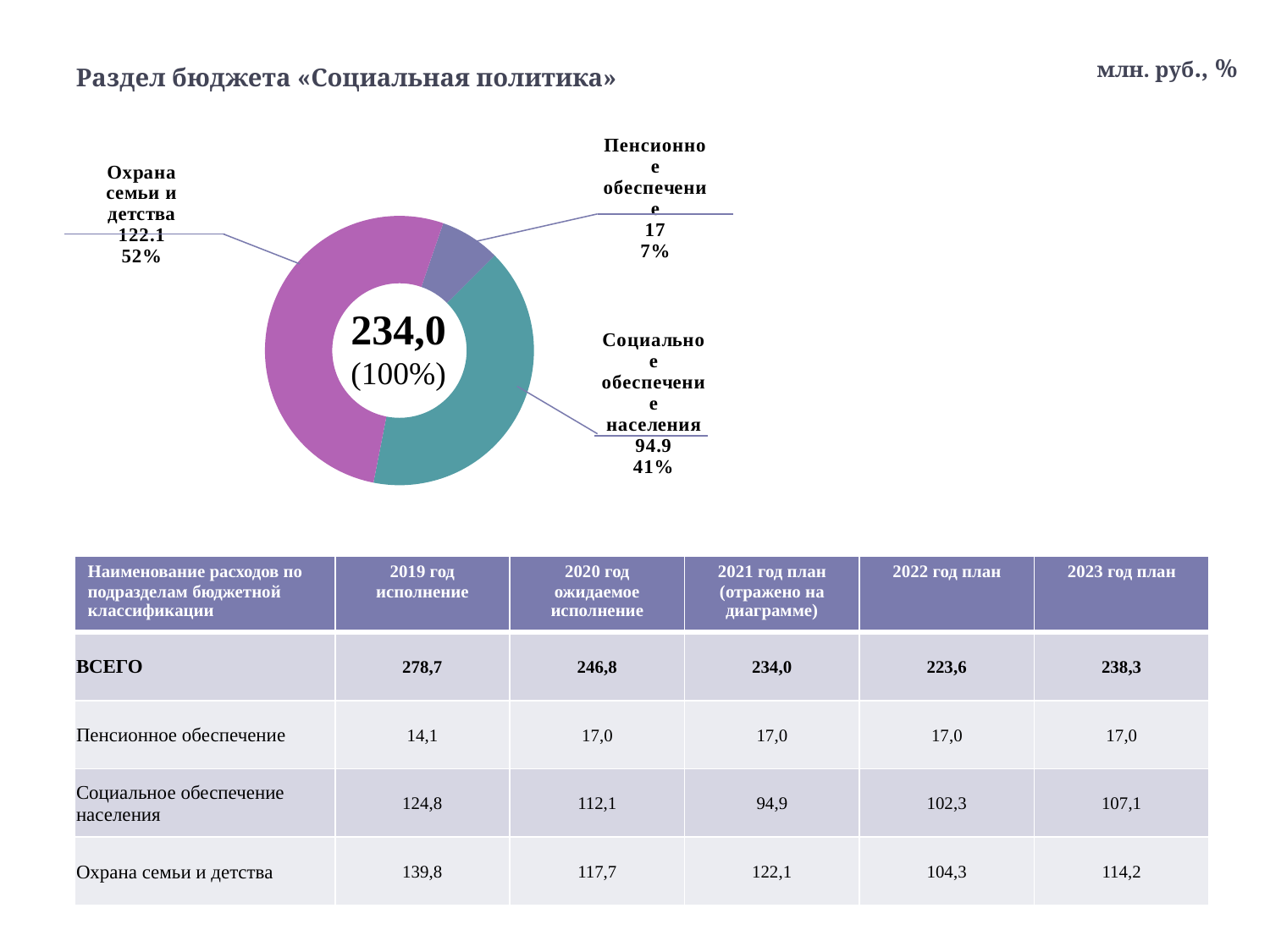
What share of the donut chart does Пенсионное обеспечение represent? 7% Which is larger on the donut chart: Социальное обеспечение населения or Пенсионное обеспечение? Социальное обеспечение населения What share of the donut chart does Охрана семьи и детства represent? 52% What value is shown for Социальное обеспечение населения on the donut chart? 94.9 Which category has the smallest slice in the donut chart? Пенсионное обеспечение What value is shown for Охрана семьи и детства on the donut chart? 122.1 What value is shown for Пенсионное обеспечение on the donut chart? 17 What is the difference between the shares of Охрана семьи и детства and Социальное обеспечение населения on the donut chart? 11% Which category has the largest slice in the donut chart? Охрана семьи и детства How many slices does the donut chart have? 3 What total value is shown in the centre of the donut chart? 234,0 What kind of chart is shown on the slide? Donut (pie) chart